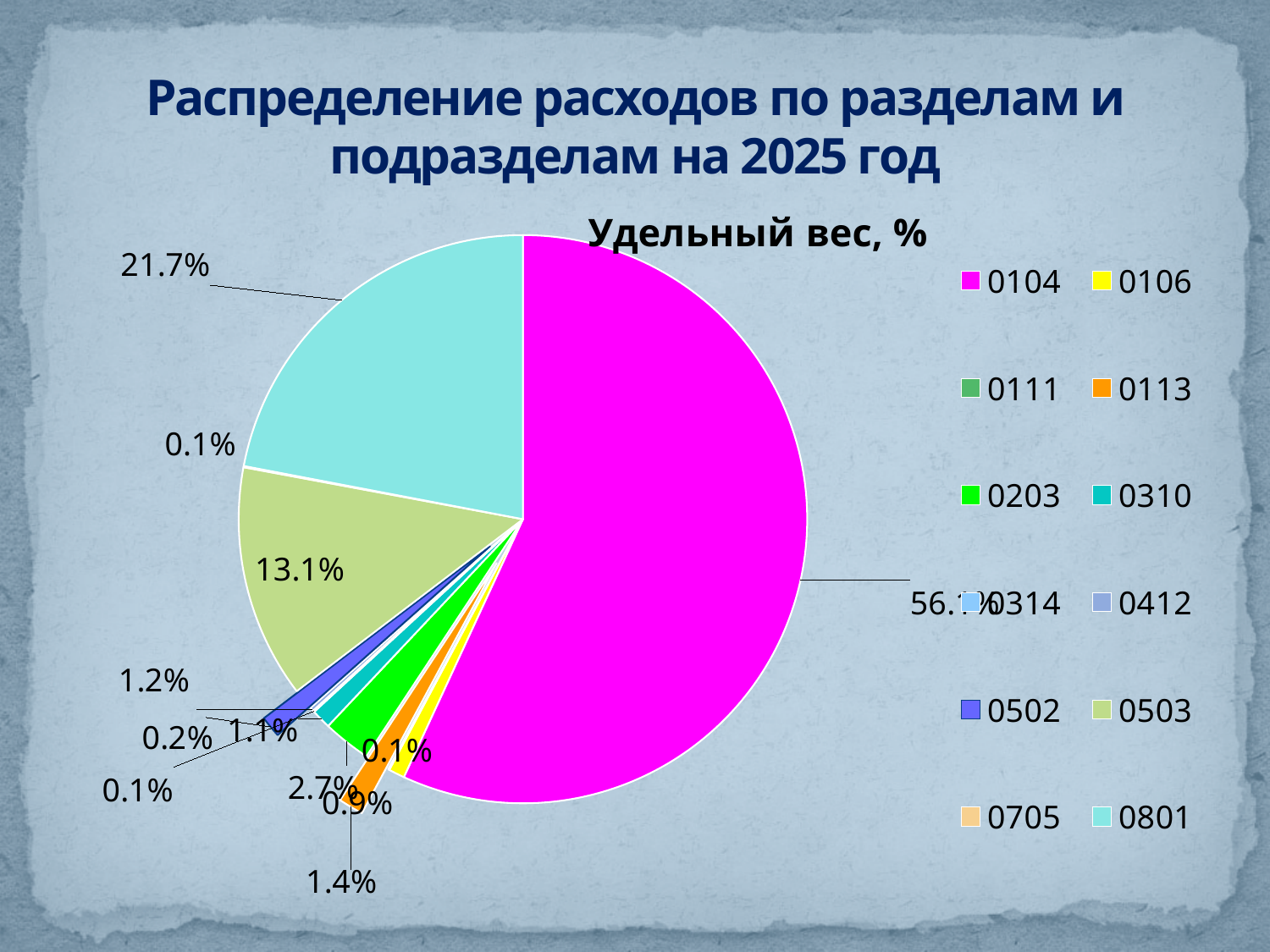
Which has the larger share, 0801 or 0503? 0801 How many categories does the chart's legend list? 12 What is the difference in share between 0801 and 0503? 8.6% What is the title of the chart? Удельный вес, % What kind of chart is shown on the slide? pie chart Which category has the largest slice of the pie? 0104 What share of the pie does category 0503 have? 13.1% What share of the pie does category 0104 have? 56.1% Is the share for 0104 greater or less than 50%? greater What is the difference in share between 0104 and 0801? 34.4% What share of the pie does category 0801 have? 21.7% What colour is the slice for category 0104? magenta